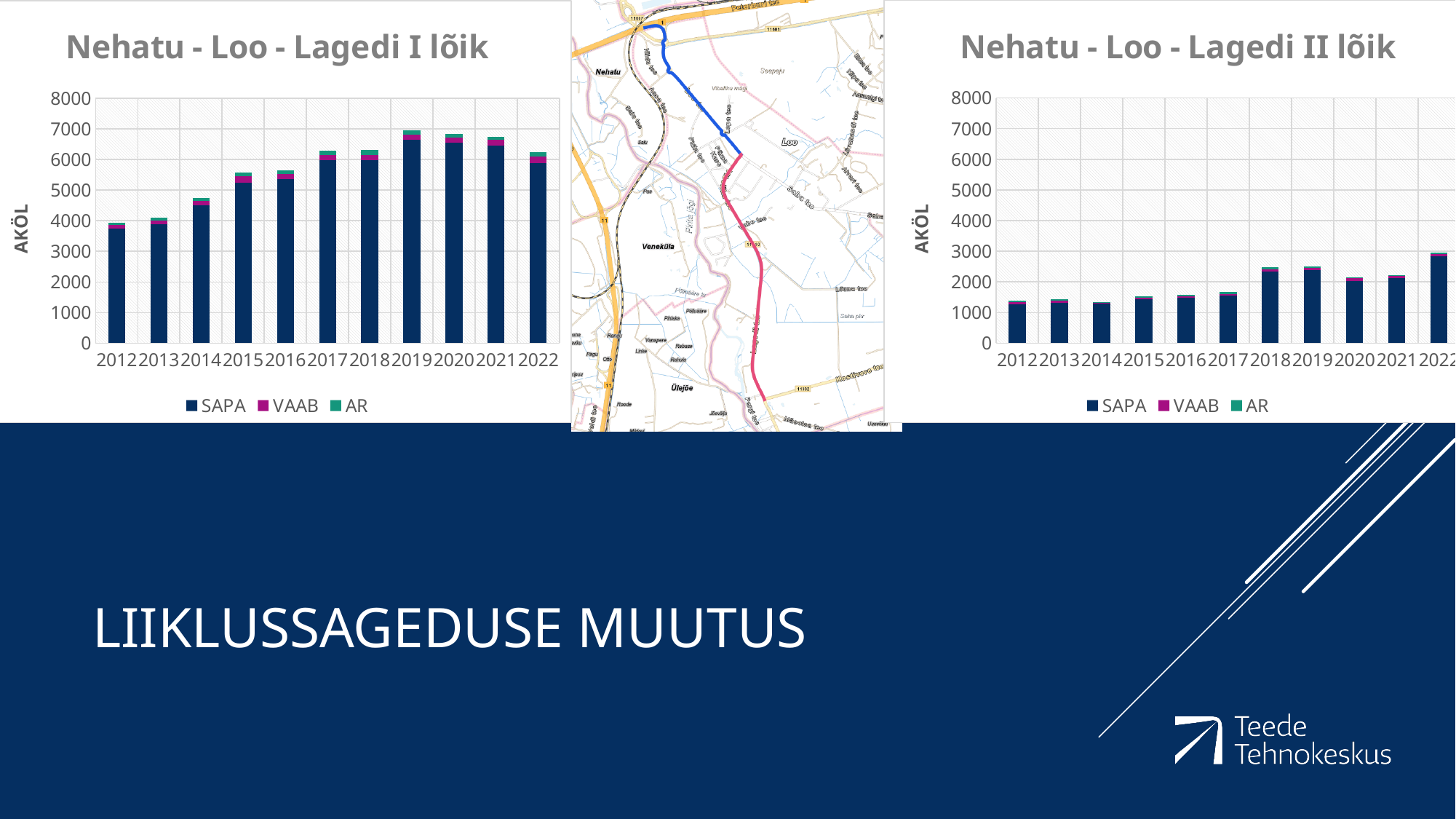
In the "Nehatu - Loo - Lagedi I lõik" chart, is the total value for 2019 greater or less than 6000? greater In the "Nehatu - Loo - Lagedi II lõik" chart, which year has the larger total bar, 2017 or 2018? 2018 In the "Nehatu - Loo - Lagedi II lõik" chart, is the total value for 2022 greater or less than 2000? greater How many years are shown on the x axis of the "Nehatu - Loo - Lagedi I lõik" chart? 11 How many series does the legend of the "Nehatu - Loo - Lagedi II lõik" chart list? 3 In the "Nehatu - Loo - Lagedi I lõik" chart, which year has the lowest total bar? 2012 In the "Nehatu - Loo - Lagedi II lõik" chart, is the total value for 2012 greater or less than 2000? less What type of chart is "Nehatu - Loo - Lagedi I lõik"? stacked bar chart In the "Nehatu - Loo - Lagedi II lõik" chart, which year has the highest total bar? 2022 What is the y-axis label of the "Nehatu - Loo - Lagedi I lõik" chart? AKÖL In the "Nehatu - Loo - Lagedi I lõik" chart, which year has the larger total bar, 2012 or 2015? 2015